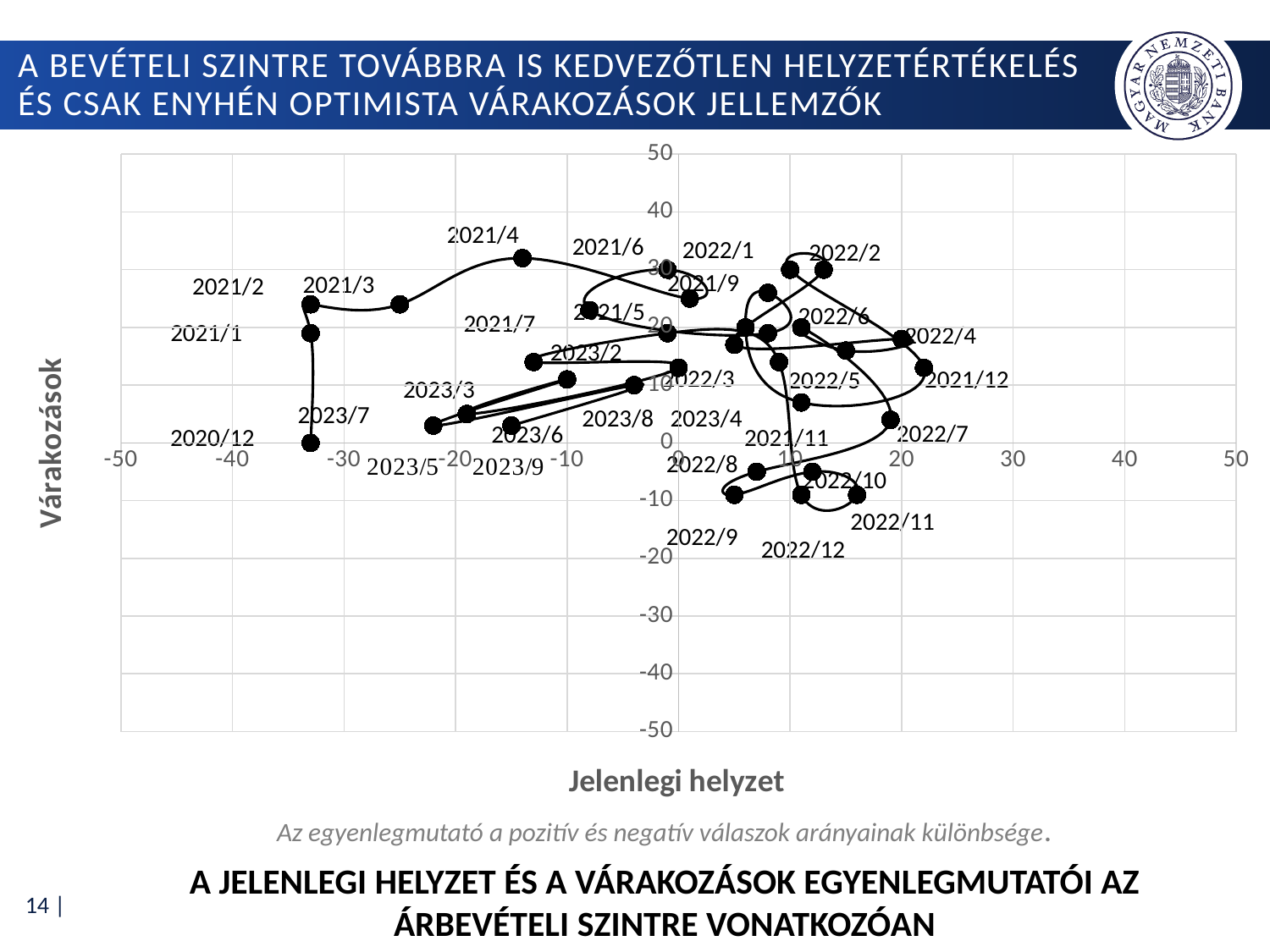
What is the title of the horizontal axis of the chart? Jelenlegi helyzet Is the vertical-axis (Várakozások) value for 2021/4 greater or less than 20? greater Which point has the larger horizontal-axis (Jelenlegi helyzet) value, 2022/4 or 2023/5? 2022/4 Is the horizontal-axis (Jelenlegi helyzet) value for 2022/4 greater or less than 10? greater Is the vertical-axis (Várakozások) value for 2022/11 greater or less than 0? less Which point has the higher vertical-axis (Várakozások) value, 2021/4 or 2020/12? 2021/4 Which point has the higher vertical-axis (Várakozások) value, 2022/2 or 2022/11? 2022/2 What is the title of the vertical axis of the chart? Várakozások What kind of chart is shown on the slide? scatter chart